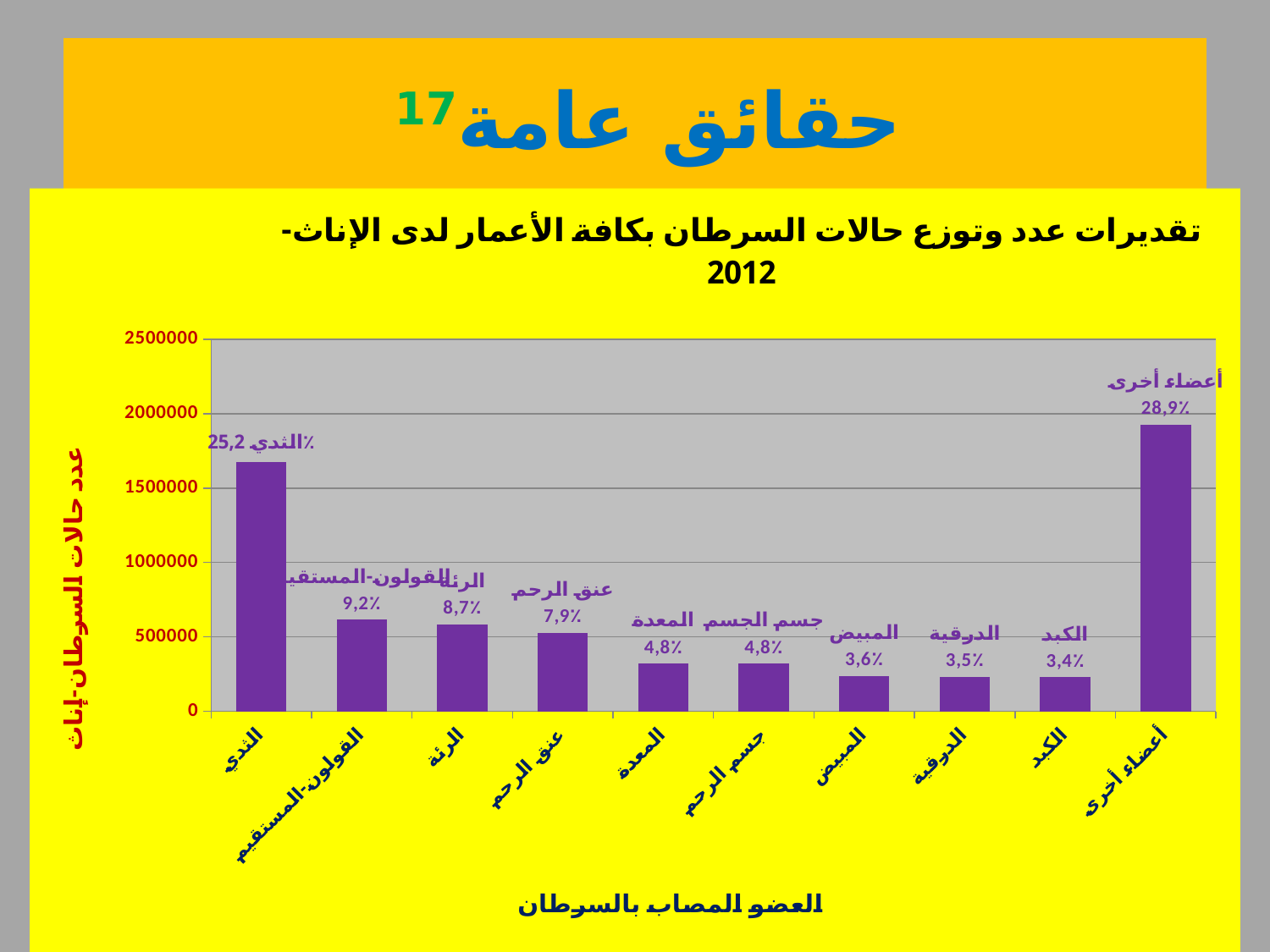
Is the value for الثدي greater or less than 1500000? greater What percentage label is shown for الثدي (breast)? 25,2% How many categories are shown on the x axis? 10 Is the value for المعدة greater or less than 500000? less What kind of chart is shown on the slide? bar chart What is the difference between the percentage labels for أعضاء أخرى and الثدي? 3,7% What percentage label is shown for الرئة (lung)? 8,7% Which category has the lowest percentage label? الكبد (3,4%) Which category has the highest bar? أعضاء أخرى What is the title of the y axis? عدد حالات السرطان-إناث What percentage label is shown for أعضاء أخرى (other organs)? 28,9% Which has a larger value, القولون-المستقيم or عنق الرحم? القولون-المستقيم